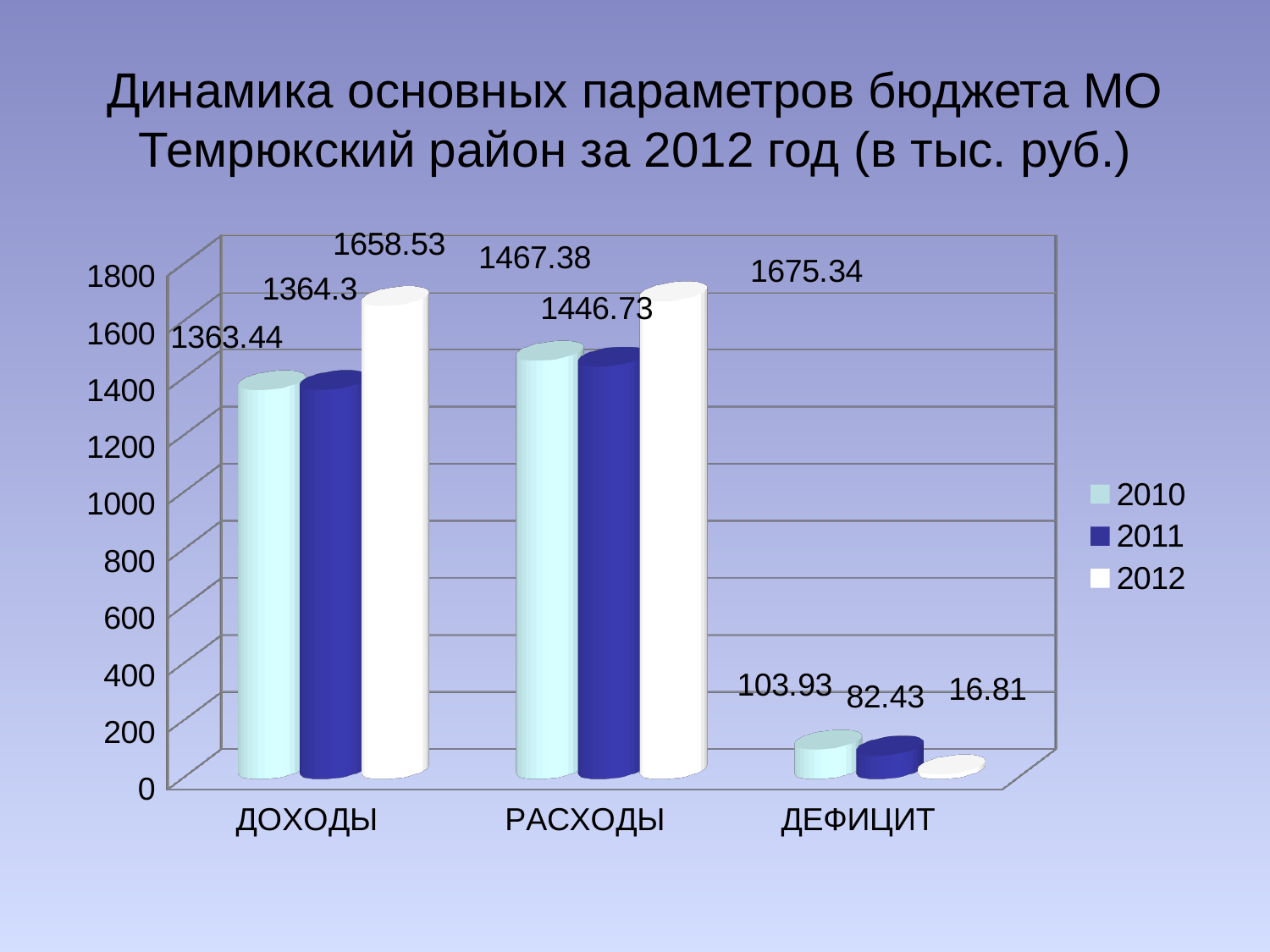
How many categories are shown on the x axis? 3 Which is larger: the 2010 value for ДЕФИЦИТ or the 2011 value for ДЕФИЦИТ? 2010 What is the value for ДОХОДЫ in 2012? 1658.53 What kind of chart is shown on the slide? bar chart Which legend entry is shown in white? 2012 How many series does the legend list? 3 Which year has the lowest value for ДЕФИЦИТ? 2012 What is the value for ДОХОДЫ in 2010? 1363.44 What is the value for РАСХОДЫ in 2010? 1467.38 What is the value for ДЕФИЦИТ in 2011? 82.43 Which year has the highest value for РАСХОДЫ? 2012 What is the difference between the 2012 and 2010 values for ДОХОДЫ? 295.09